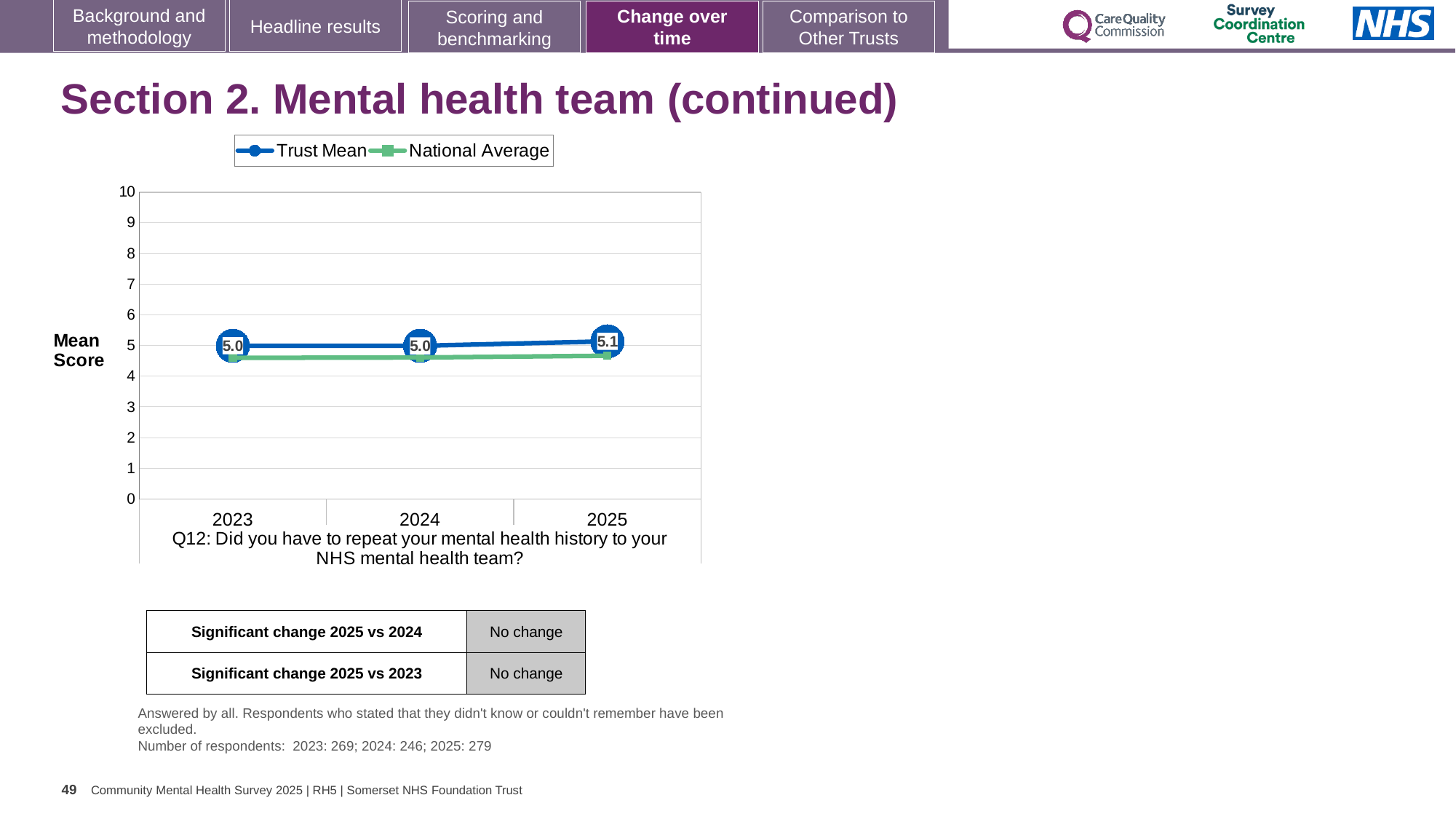
In 2025, which is larger: the Trust Mean or the National Average? Trust Mean Is the National Average value for 2023 greater or less than 5? less How many series does the legend list? 2 Is the National Average value for 2025 greater or less than 4? greater What is the label on the y axis of the chart? Mean Score In which year is the Trust Mean highest? 2025 What is the Trust Mean value for 2023? 5.0 What is the Trust Mean value for 2024? 5.0 What kind of chart is shown on the slide? Line chart How many years are plotted on the x axis? 3 What is the difference between the Trust Mean in 2025 and in 2023? 0.1 What is the Trust Mean value for 2025? 5.1